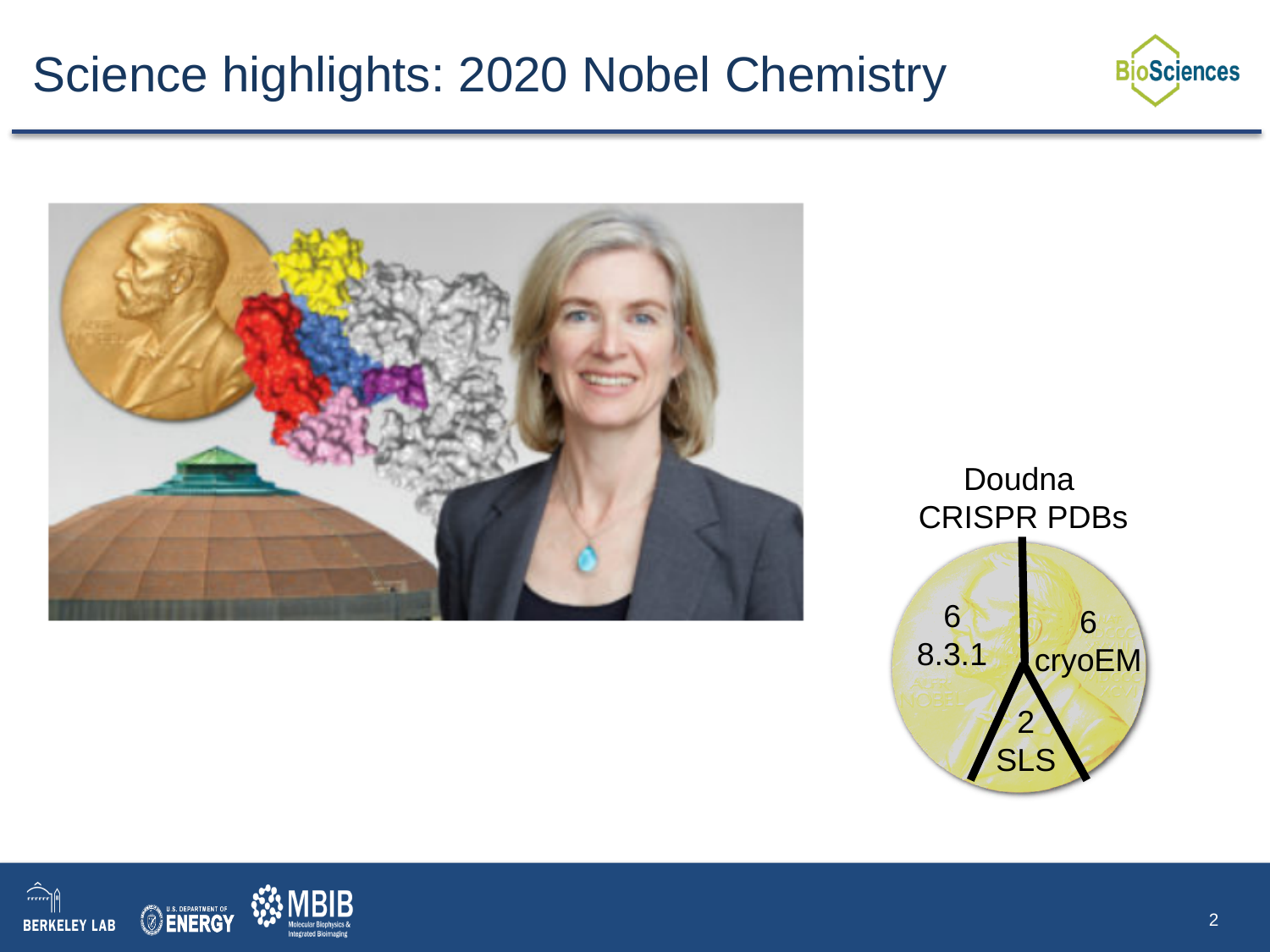
What is the value for the SLS slice in the Doudna CRISPR PDBs pie chart? 2 What is the title of the pie chart? Doudna CRISPR PDBs What type of chart is shown on the slide? pie chart What is the total of all slices in the Doudna CRISPR PDBs pie chart? 14 What is the difference between the cryoEM value and the SLS value in the Doudna CRISPR PDBs pie chart? 4 What is the value for the cryoEM slice in the Doudna CRISPR PDBs pie chart? 6 What image is used as the background of the Doudna CRISPR PDBs pie chart? a Nobel medal Which is larger in the Doudna CRISPR PDBs pie chart, the 8.3.1 slice or the SLS slice? 8.3.1 What fraction of the total does the SLS slice represent in the Doudna CRISPR PDBs pie chart? 2/14 What is the value for the 8.3.1 slice in the Doudna CRISPR PDBs pie chart? 6 Which slice of the Doudna CRISPR PDBs pie chart has the smallest value? SLS How many slices does the Doudna CRISPR PDBs pie chart have? 3